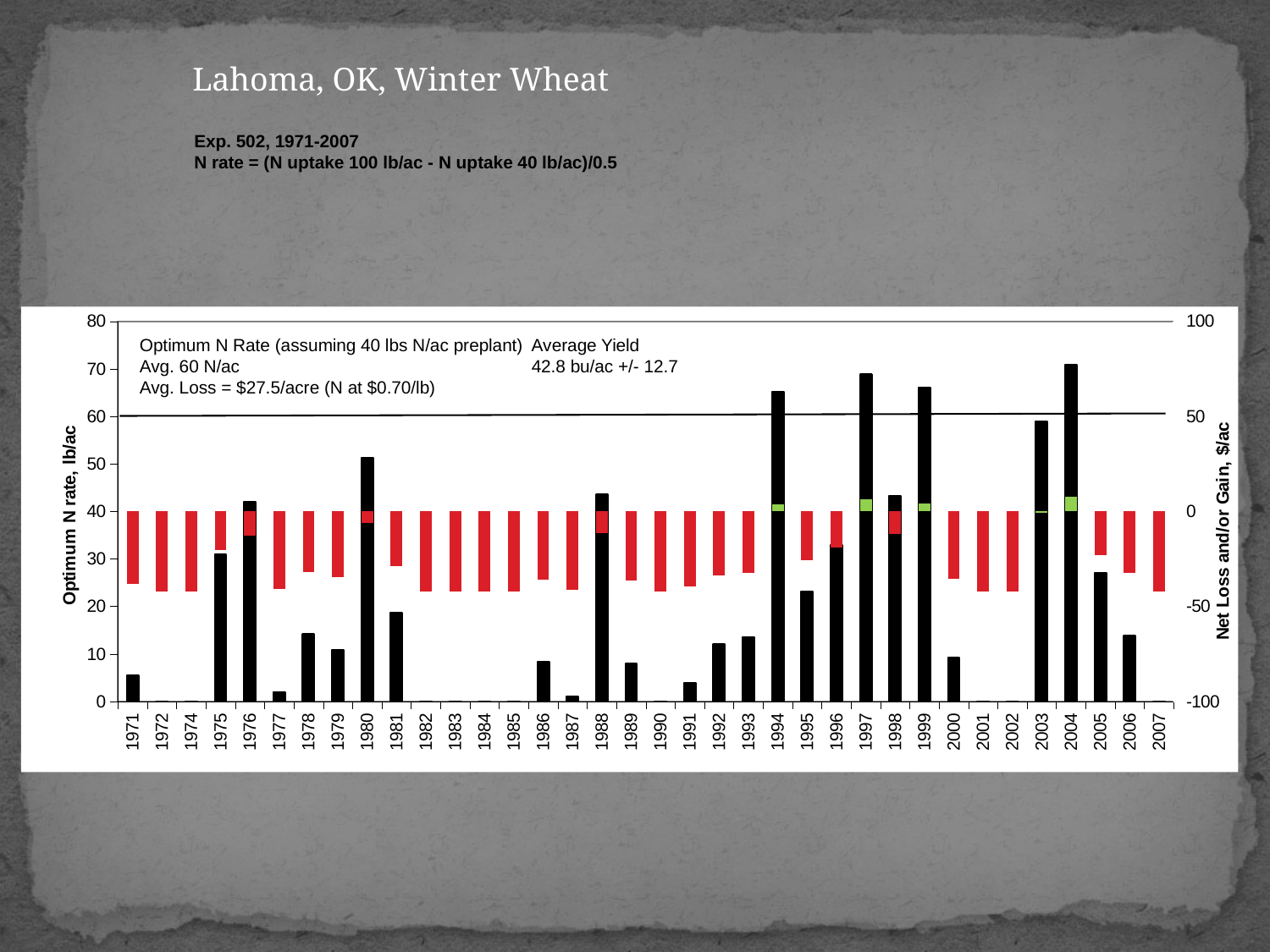
Which year has the larger optimum N rate, 1980 or 1981? 1980 Is the optimum N rate for 1999 greater or less than 60 lb/ac? greater Is the optimum N rate for 1978 greater or less than 10 lb/ac? greater Which year has the larger optimum N rate, 1994 or 1995? 1994 Is the optimum N rate for 1994 greater or less than 60 lb/ac? greater What is the title of the left vertical axis of the chart? Optimum N rate, lb/ac Which year has the larger optimum N rate, 1988 or 1989? 1988 What kind of chart is shown on the slide? bar chart How many years are shown along the x axis of the chart? 36 What average optimum N rate is stated in the text inside the chart? 60 N/ac